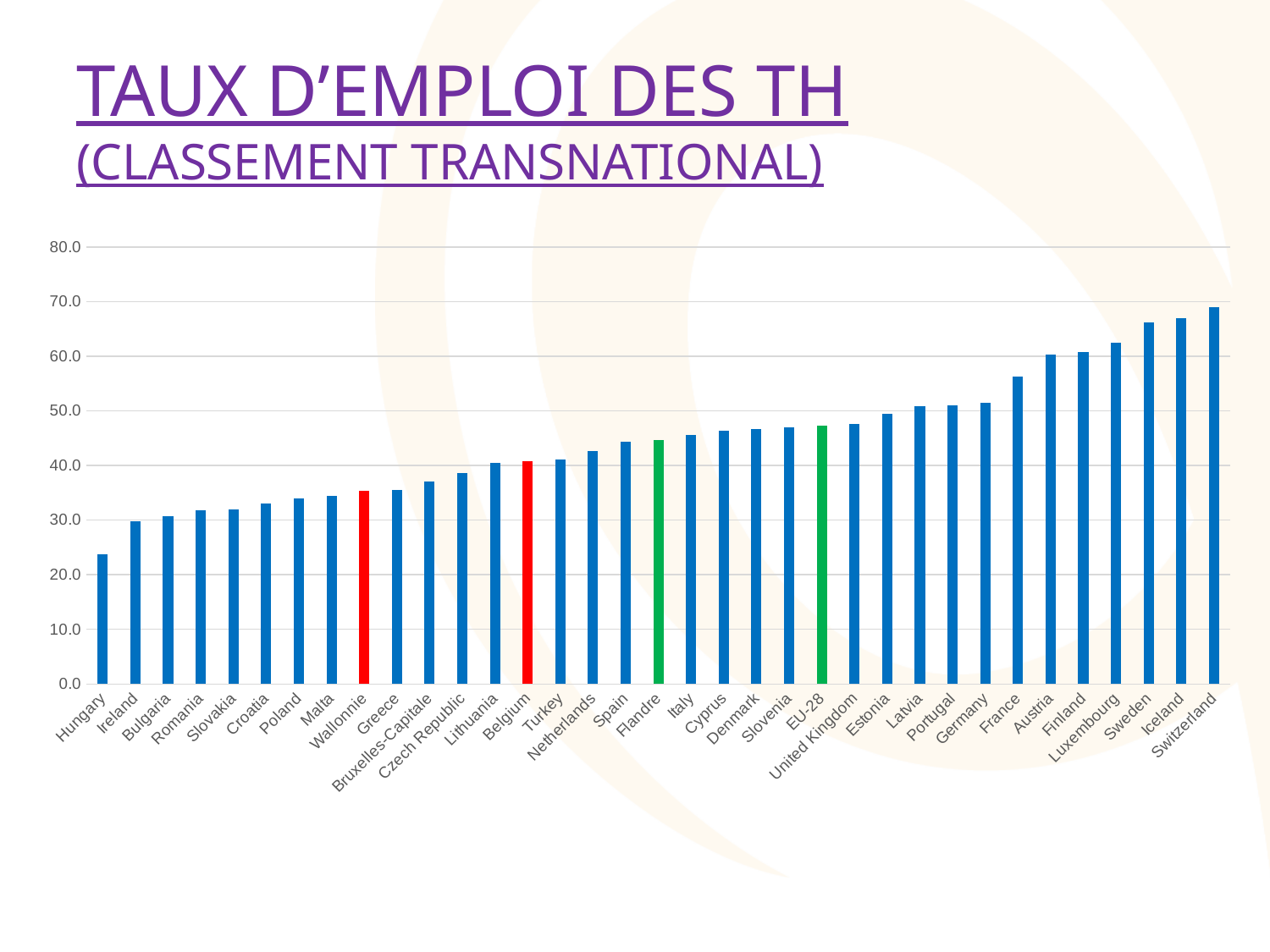
Which category has the highest value? Switzerland Is the value for Wallonnie greater or less than 40.0? less Is the value for Switzerland greater or less than 70.0? less Which is larger, the value for Flandre or the value for Wallonnie? Flandre Is the value for Flandre greater or less than 40.0? greater How many categories are plotted on the x axis? 35 What colour are the bars for Wallonnie and Belgium? red Do the values rise or fall from left to right along the x axis? rise What kind of chart is shown on the slide? bar chart Which category has the lowest value? Hungary